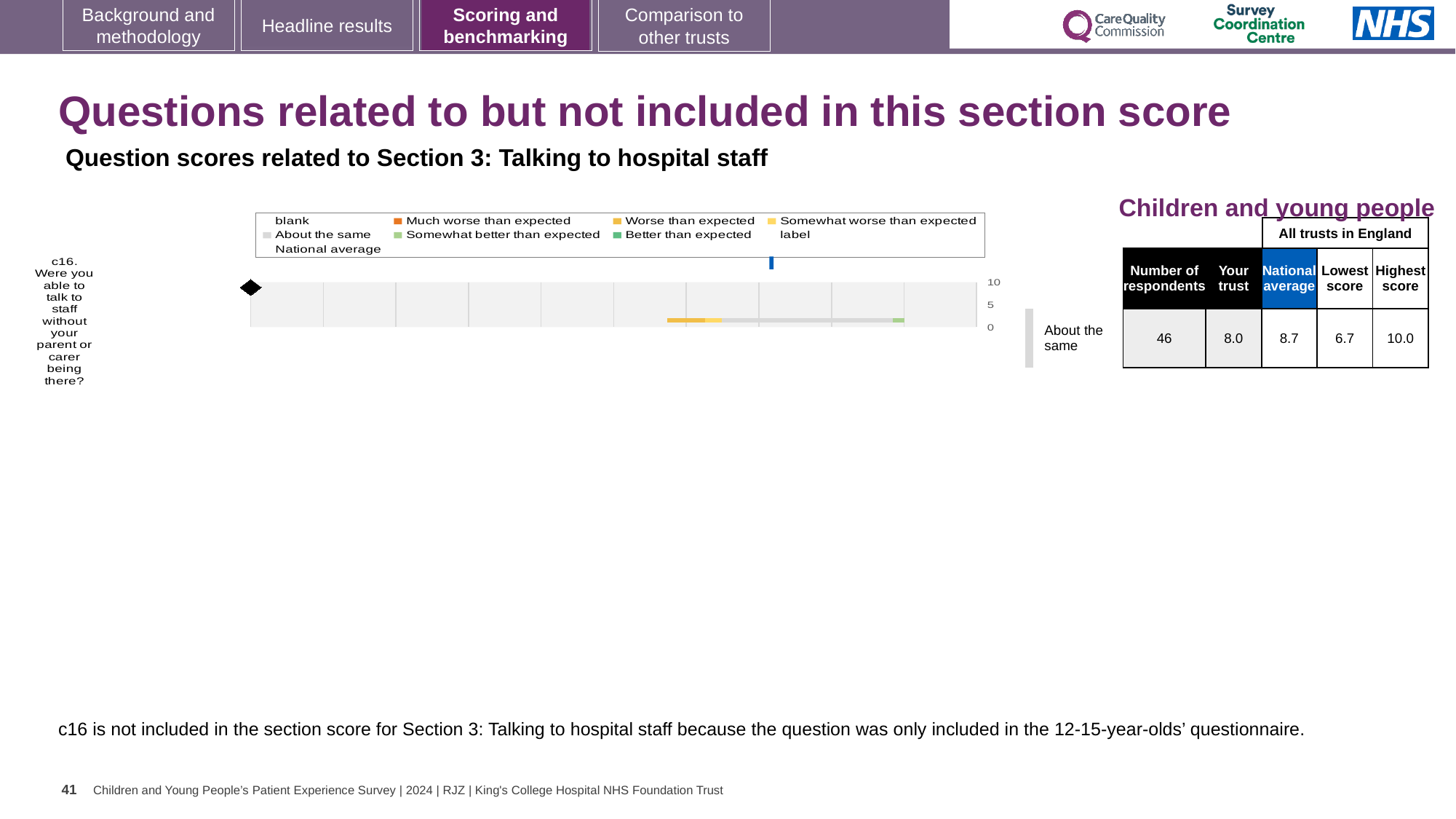
What kind of chart is used to show the c16 question score? bar chart What is the difference between the highest score and the lowest score for c16? 3.3 What is the highest score among all trusts in England for c16? 10.0 What is the number of respondents for c16 in the table? 46 What is the highest value shown on the chart's score axis? 10 What is the national average score for c16? 8.7 What is the 'Your trust' score for c16? 8.0 What is the difference between the national average and the 'Your trust' score for c16? 0.7 Which benchmark category is c16 assigned to on the slide? About the same Which is larger for c16, the 'Your trust' score or the national average? National average How many questions are plotted on the chart? 1 What is the lowest score among all trusts in England for c16? 6.7